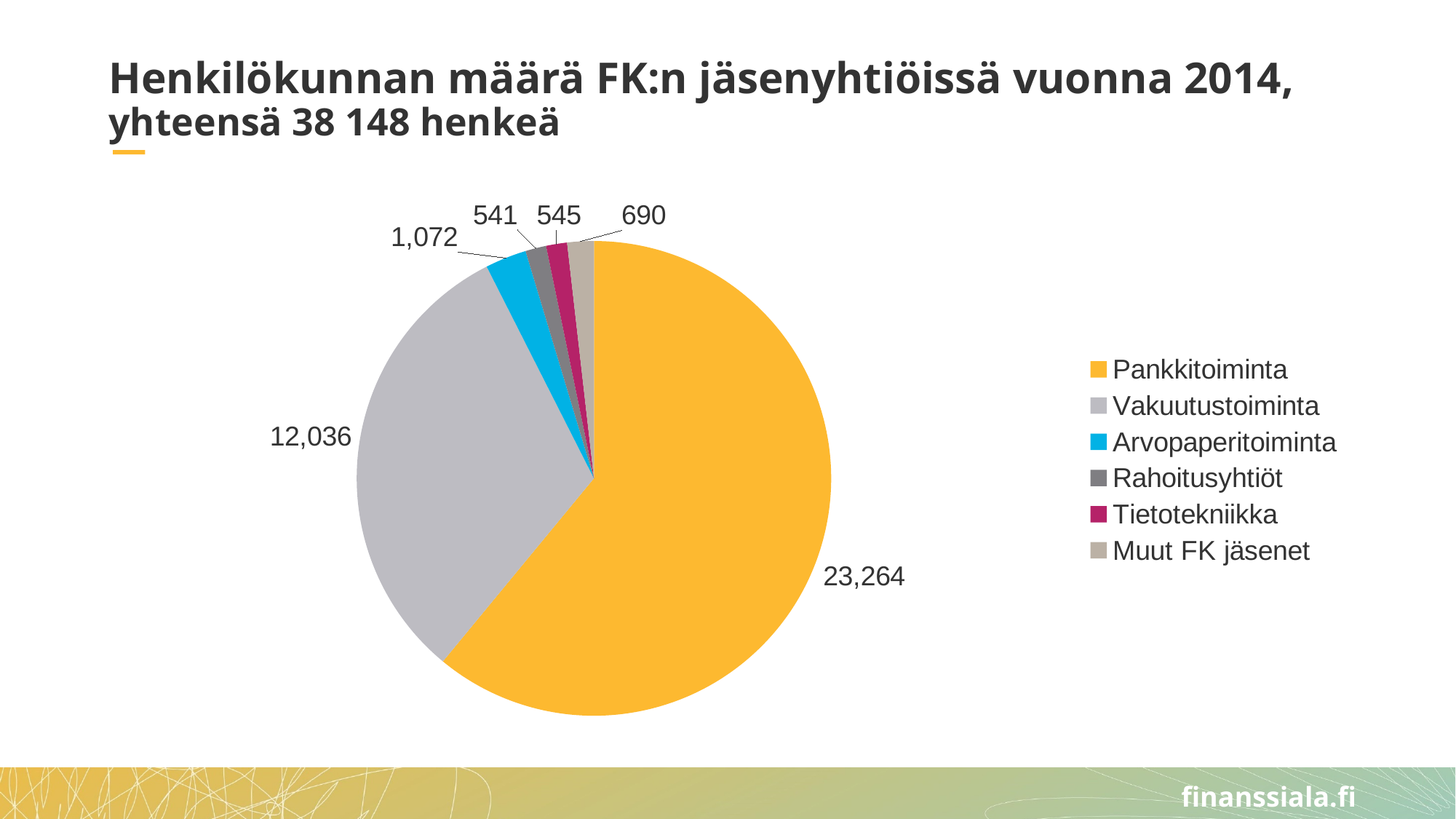
What is the value shown for Vakuutustoiminta? 12,036 How many people does the Pankkitoiminta slice represent? 23,264 How many categories does the legend of the pie chart list? 6 Which category has the largest slice of the pie? Pankkitoiminta What is the value shown for Arvopaperitoiminta? 1,072 What is the difference between the values for Muut FK jäsenet and Tietotekniikka? 145 Which is larger, the value for Muut FK jäsenet or the value for Tietotekniikka? Muut FK jäsenet What is the difference between the values for Pankkitoiminta and Vakuutustoiminta? 11,228 What kind of chart is shown on the slide? pie chart What total number of people does the slide title state for 2014? 38 148 What is the value shown for Muut FK jäsenet? 690 Which category has the smallest value in the pie chart? Rahoitusyhtiöt